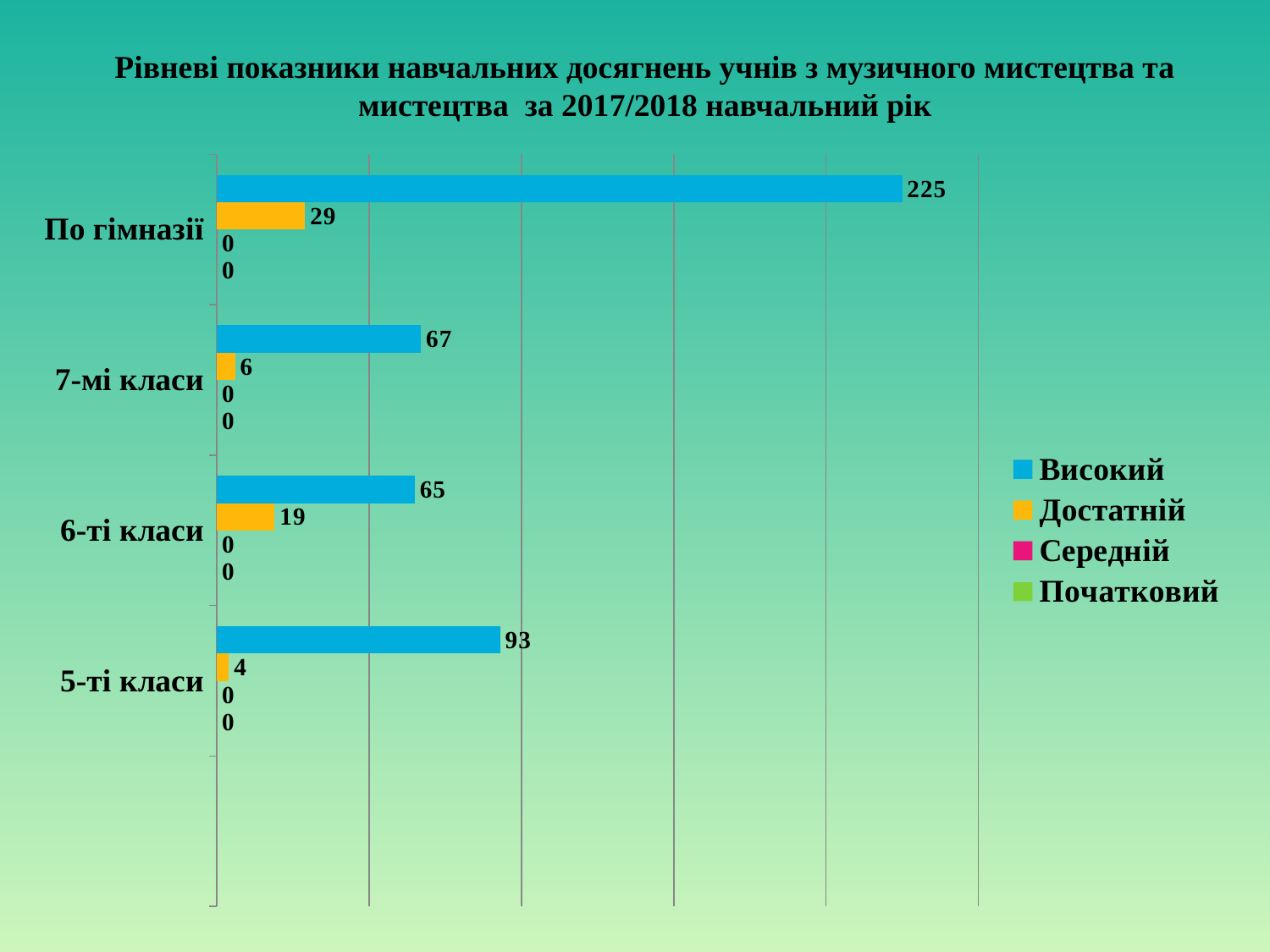
What is the value of Високий for 5-ті класи? 93 What is the value of Середній for 7-мі класи? 0 What is the value of Достатній for 7-мі класи? 6 How many categories are shown on the chart? 4 What is the difference between the Високий values for 5-ті класи and 6-ті класи? 28 What is the value of Високий for По гімназії? 225 Which category has the lowest Достатній value? 5-ті класи Which is larger: the Достатній value for 6-ті класи or for 7-мі класи? 6-ті класи How many series does the legend list? 4 What is the value of Достатній for 6-ті класи? 19 Which class group has the highest Високий value among 5-ті, 6-ті and 7-мі класи? 5-ті класи What kind of chart is shown on the slide? Bar chart